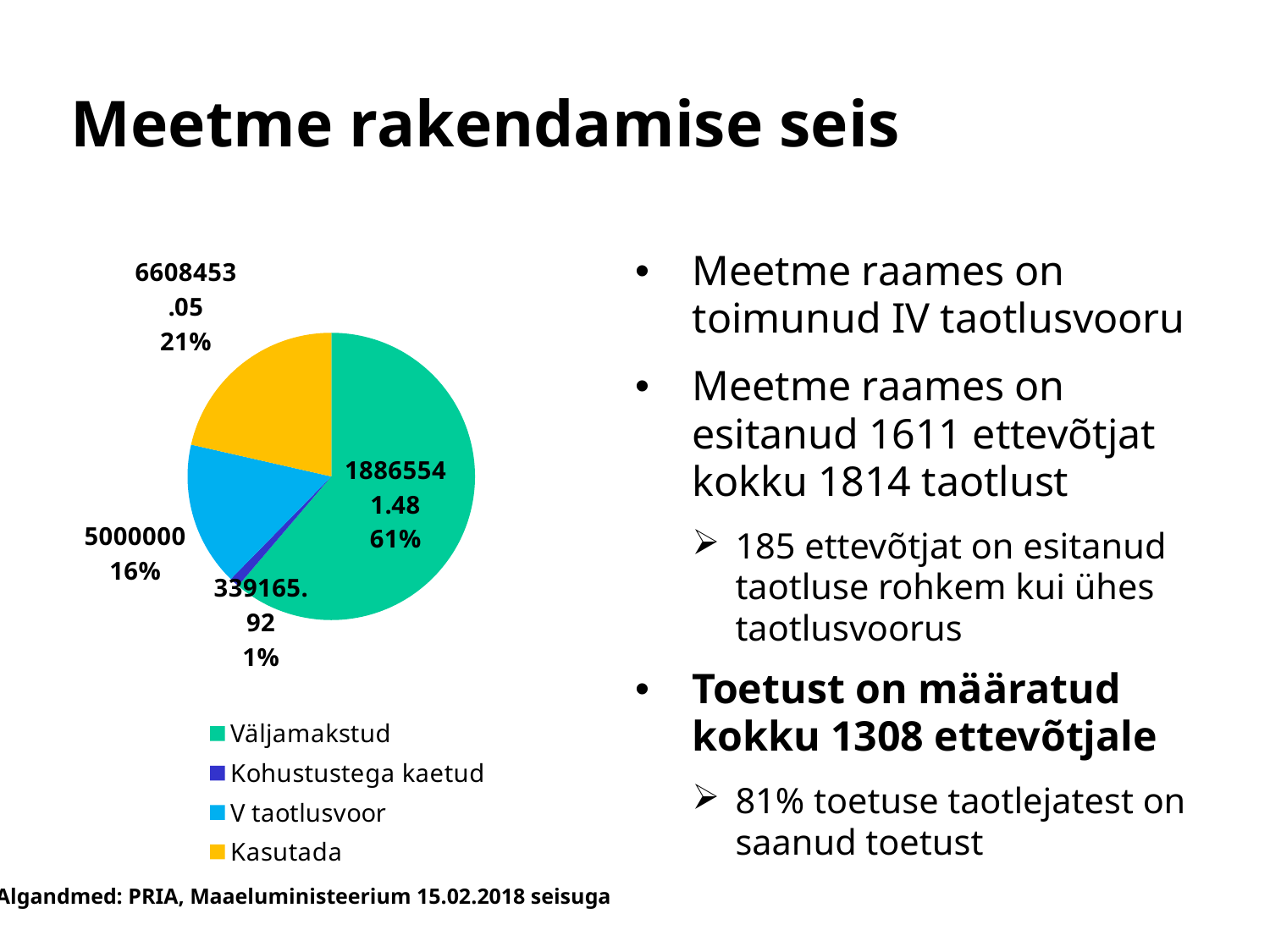
What kind of chart is shown on the slide? pie chart What percentage share does the Väljamakstud slice have in the pie chart? 61% Which slice is larger in the pie chart, Kasutada or V taotlusvoor? Kasutada What percentage share does the V taotlusvoor slice have in the pie chart? 16% What percentage share does the Kohustustega kaetud slice have in the pie chart? 1% How many slices does the pie chart have? 4 Which slice of the pie chart is the largest? Väljamakstud What value is shown for the V taotlusvoor slice in the pie chart? 5000000 What colour is the Kasutada slice in the pie chart? yellow How many entries does the legend of the pie chart list? 4 Which slice of the pie chart is the smallest? Kohustustega kaetud